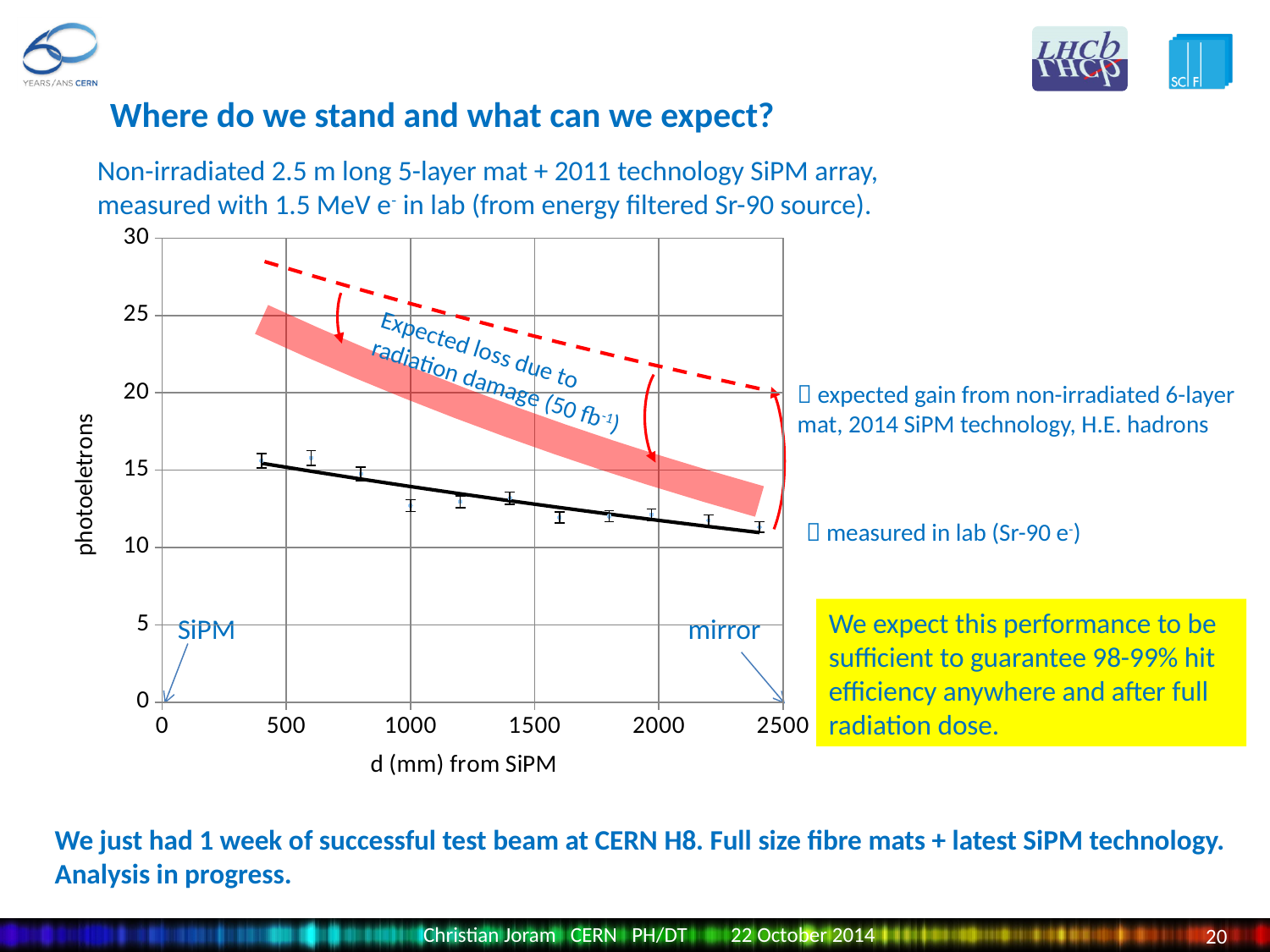
Is the dashed expected-gain line at d = 500 mm greater or less than 25 photoelectrons? greater Is the measured value at d = 1000 mm greater or less than 15 photoelectrons? less What is the label of the y axis? photoeletrons What kind of chart is shown on the slide? line chart with error bars (scatter plot) Is the dashed expected-gain line at d = 2500 mm greater or less than 15 photoelectrons? greater What is the label of the x axis? d (mm) from SiPM Which measured value is larger: at d = 400 mm or at d = 2400 mm? d = 400 mm Do the measured photoelectron values rise or fall as d (mm) from SiPM increases? fall